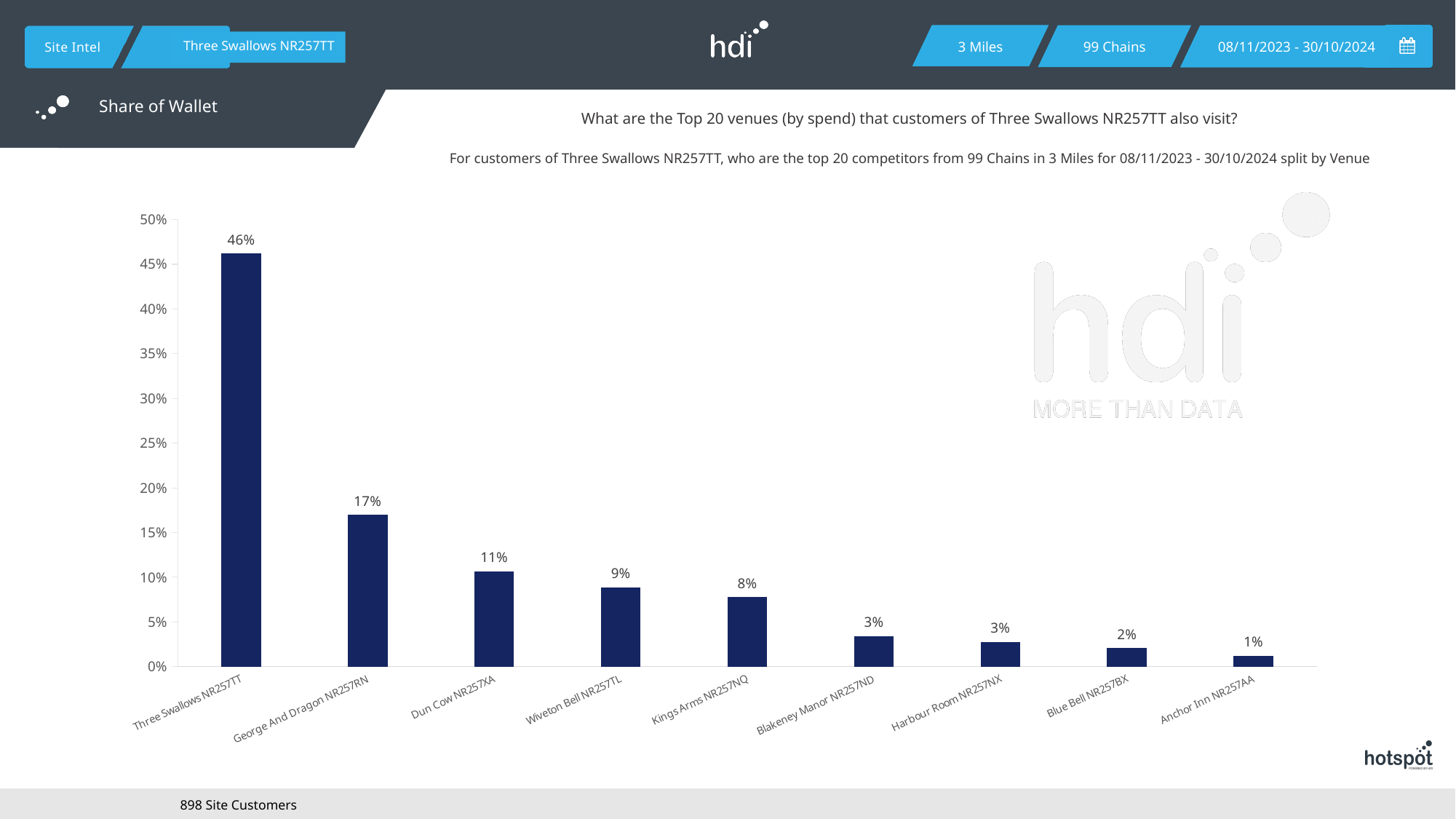
Which is larger, the value for Wiveton Bell NR257TL or the value for Kings Arms NR257NQ? Wiveton Bell NR257TL Which venue has the lowest value? Anchor Inn NR257AA What is the difference between the values for Three Swallows NR257TT and George And Dragon NR257RN? 29% What is the value for Kings Arms NR257NQ? 8% What is the value for Three Swallows NR257TT? 46% What kind of chart is shown on the slide? Bar chart Do the values rise or fall from left to right along the x axis? Fall Which venue has the highest value? Three Swallows NR257TT Is the value for Dun Cow NR257XA greater or less than 10%? greater How many venues are shown on the chart? 9 What is the value for Dun Cow NR257XA? 11% What is the value for George And Dragon NR257RN? 17%